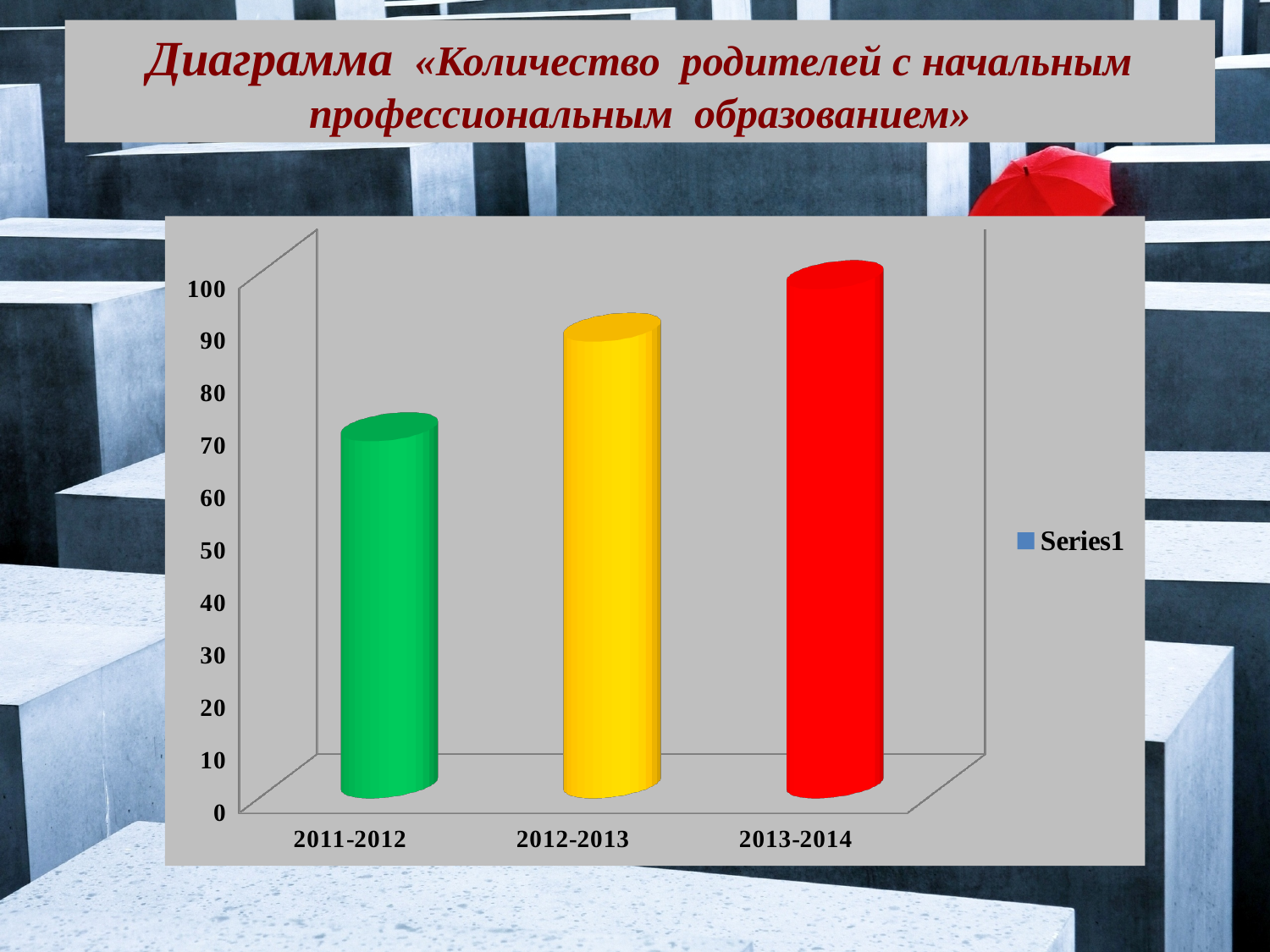
What is the name of the series shown in the chart legend? Series1 Is the value for 2011-2012 greater or less than 80? less How many categories are shown on the x axis of the chart? 3 Which category has the lowest bar? 2011-2012 Do the values rise or fall from 2011-2012 to 2013-2014? rise How many series does the chart legend list? 1 What kind of chart is shown on the slide? bar chart Is the value for 2013-2014 greater or less than 90? greater What colour is the bar for 2012-2013? yellow Which is larger, the value for 2011-2012 or the value for 2012-2013? 2012-2013 Is the value for 2012-2013 greater or less than 80? greater Which category has the highest bar? 2013-2014